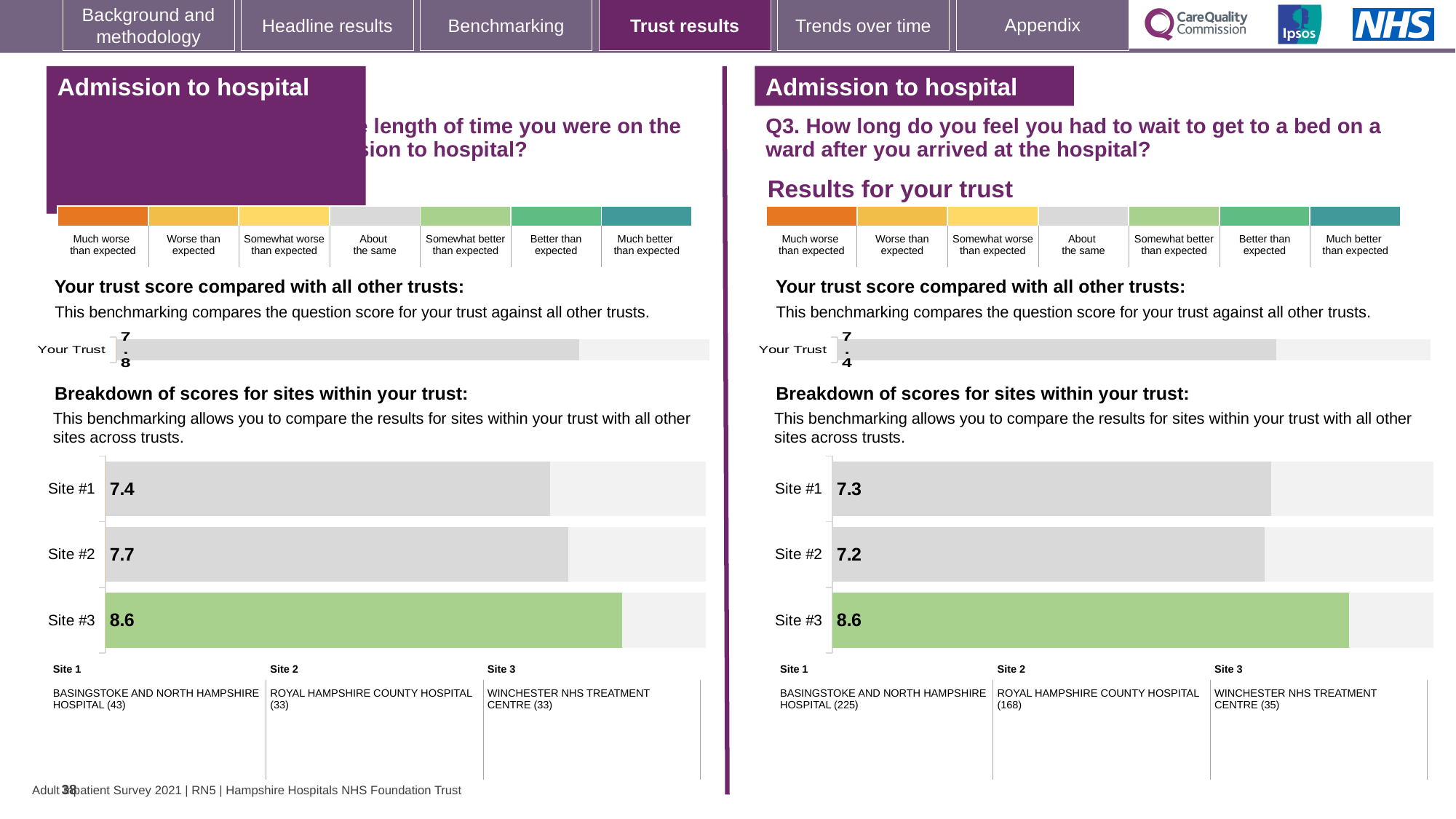
In the left-hand panel, what is the 'Your Trust' score shown in the trust comparison bar? 7.8 In the left-hand panel's site breakdown chart, what is the score for Site #3? 8.6 How many sites are shown in the right-hand panel (Q3) site breakdown chart? 3 In the right-hand panel (Q3), what is the 'Your Trust' score shown in the trust comparison bar? 7.4 In the right-hand panel (Q3) site breakdown chart, what is the difference between the Site #3 score and the Site #2 score? 1.4 In the left-hand panel's site breakdown chart, what is the difference between the Site #3 score and the Site #1 score? 1.2 In the left-hand panel's site breakdown chart, which site has the lowest score? Site #1 In the left-hand panel's site breakdown chart, what is the score for Site #1? 7.4 What type of chart is used for the site breakdown in the left-hand panel? Bar chart In the right-hand panel (Q3) site breakdown chart, which site has the lowest score? Site #2 In the right-hand panel (Q3) site breakdown chart, which site has the highest score? Site #3 In the right-hand panel (Q3) site breakdown chart, what is the score for Site #2? 7.2